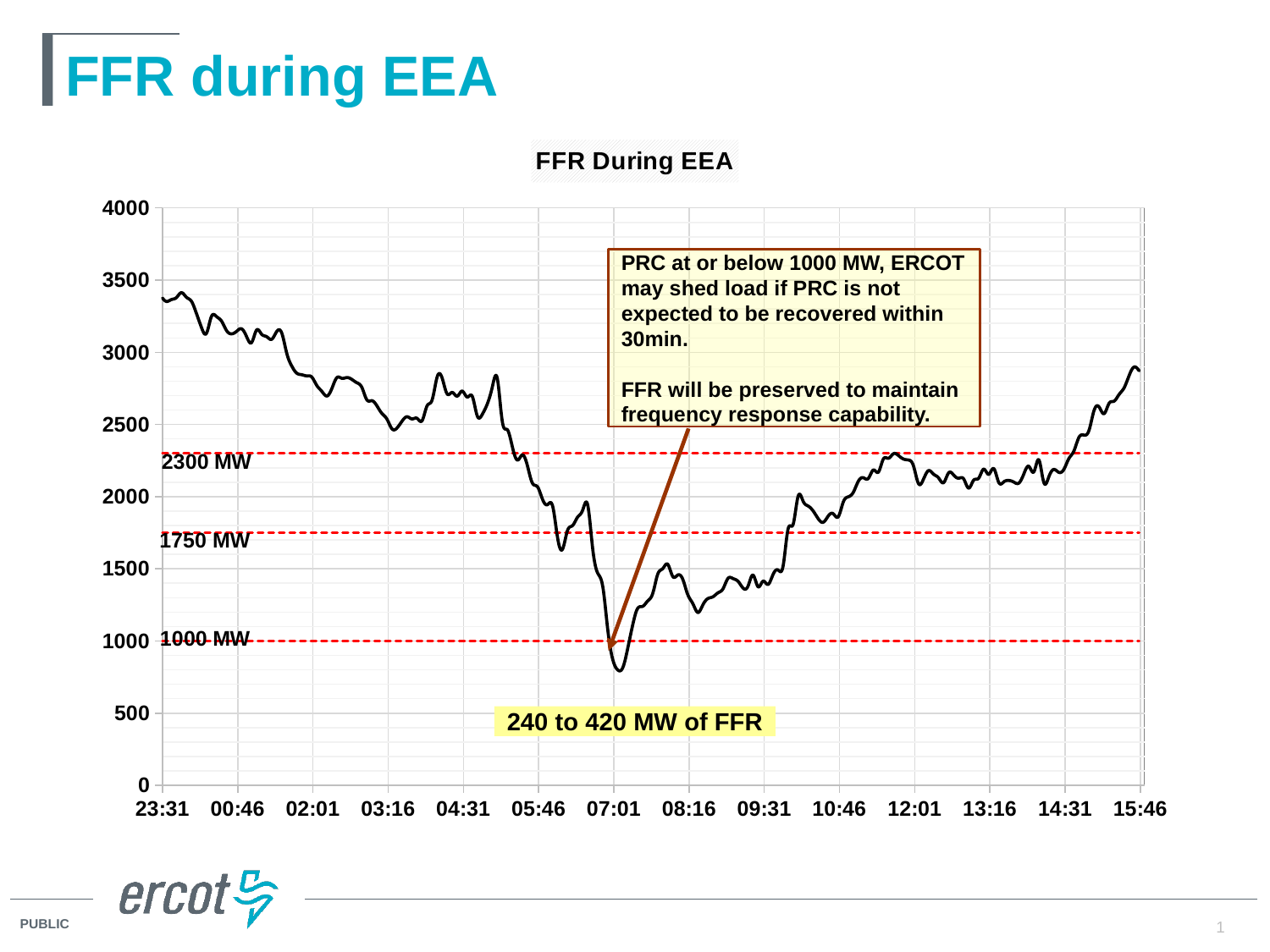
Is the value at 02:01 greater or less than 2500? greater How many time labels are shown on the x axis? 14 Is the value at 09:31 greater or less than 2000? less Does the line rise or fall between 23:31 and 07:01? fall What are the labels of the three dashed horizontal reference lines on the chart? 2300 MW, 1750 MW, 1000 MW Is the value at 12:01 greater or less than 2500? less What kind of chart is shown on the slide? line chart What is the title of the chart? FFR During EEA Which is larger, the value at 23:31 or the value at 15:46? 23:31